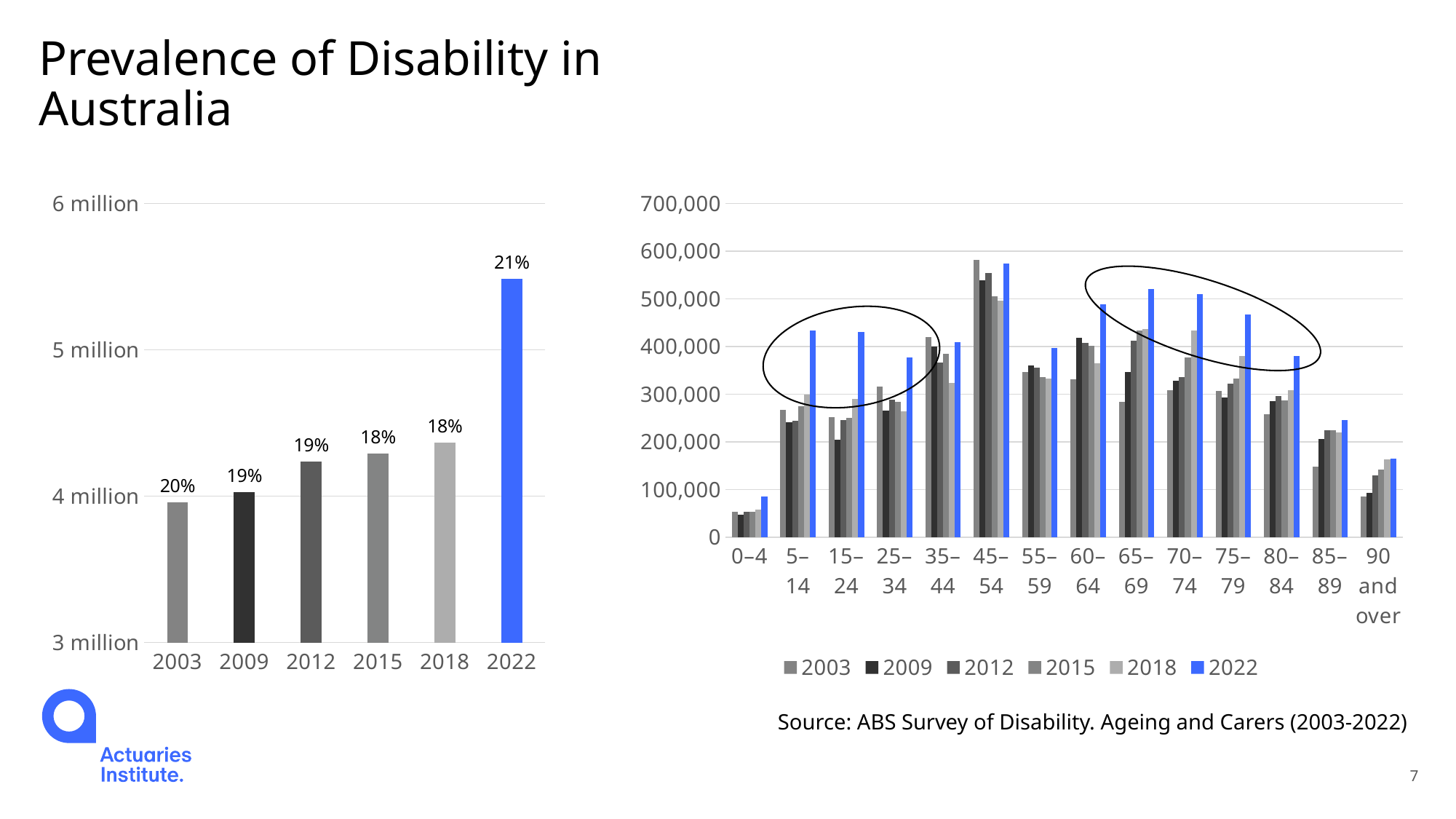
On the left chart, is the value for 2003 greater or less than 4 million? less On the left chart, how many years are plotted? 6 On the right chart, which colour represents the 2022 series in the legend? blue On the left chart, is the value for 2022 greater or less than 5 million? greater On the left chart, what percentage label is shown above the 2003 bar? 20% On the right chart, how many series does the legend list? 6 On the left chart, what percentage label is shown above the 2022 bar? 21% On the right chart, is the 2022 value for the 0–4 age group greater or less than 100,000? less On the left chart, which year has the tallest bar? 2022 On the right chart, how many age groups are shown on the x axis? 14 What kind of chart is the left chart? bar chart On the right chart, which age group has the highest 2022 value? 45–54